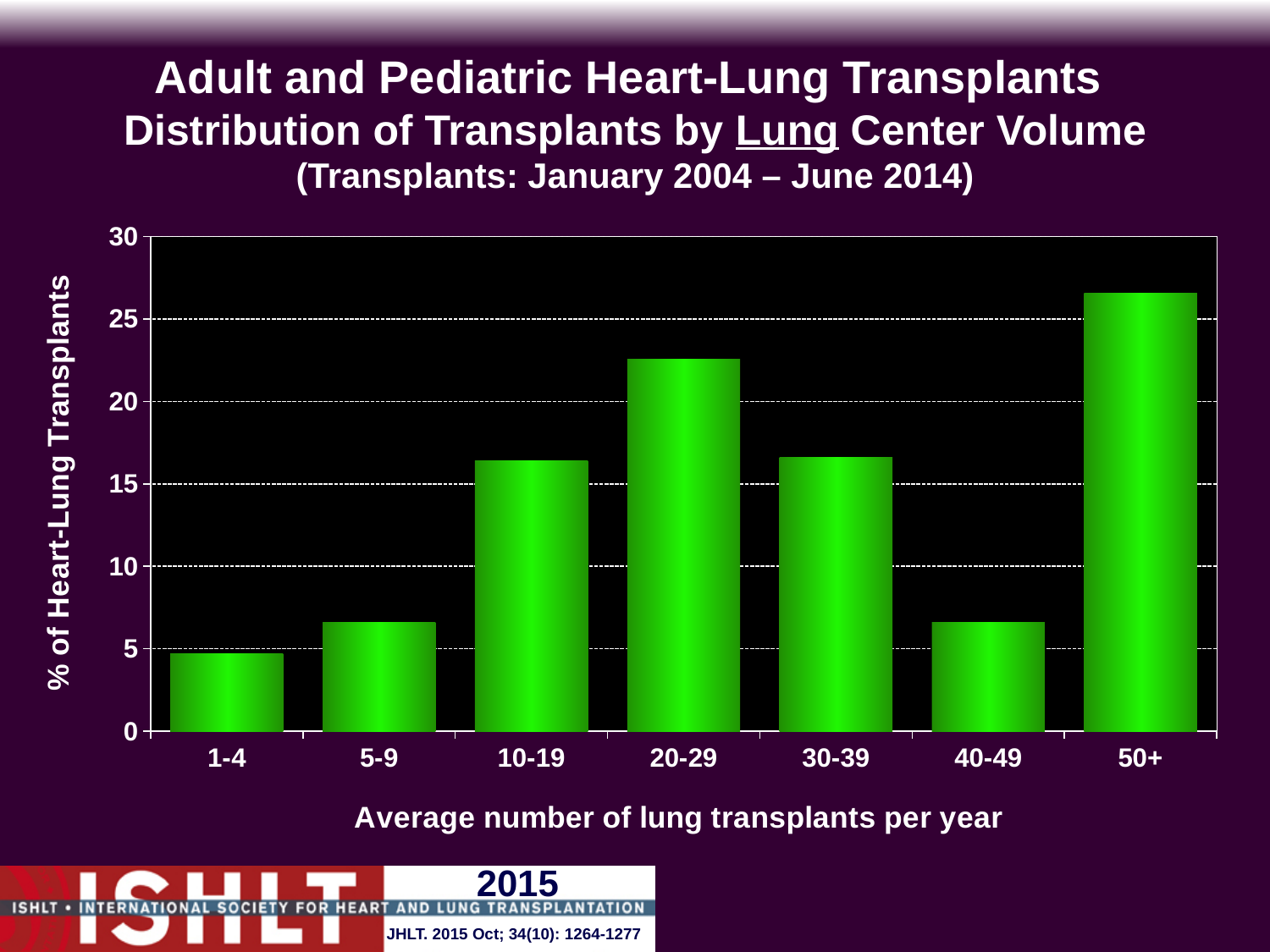
Is the value for the 20-29 category greater or less than 20? greater Is the value for the 40-49 category greater or less than 10? less What kind of chart is shown on the slide? bar chart Which center-volume category has the lowest percentage of heart-lung transplants? 1-4 Is the value for the 50+ category greater or less than 25? greater Which has a larger percentage of heart-lung transplants, the 20-29 category or the 30-39 category? 20-29 How many center-volume categories are shown on the x axis? 7 What is the label of the x axis? Average number of lung transplants per year Which has a larger percentage of heart-lung transplants, the 50+ category or the 40-49 category? 50+ Which center-volume category has the highest percentage of heart-lung transplants? 50+